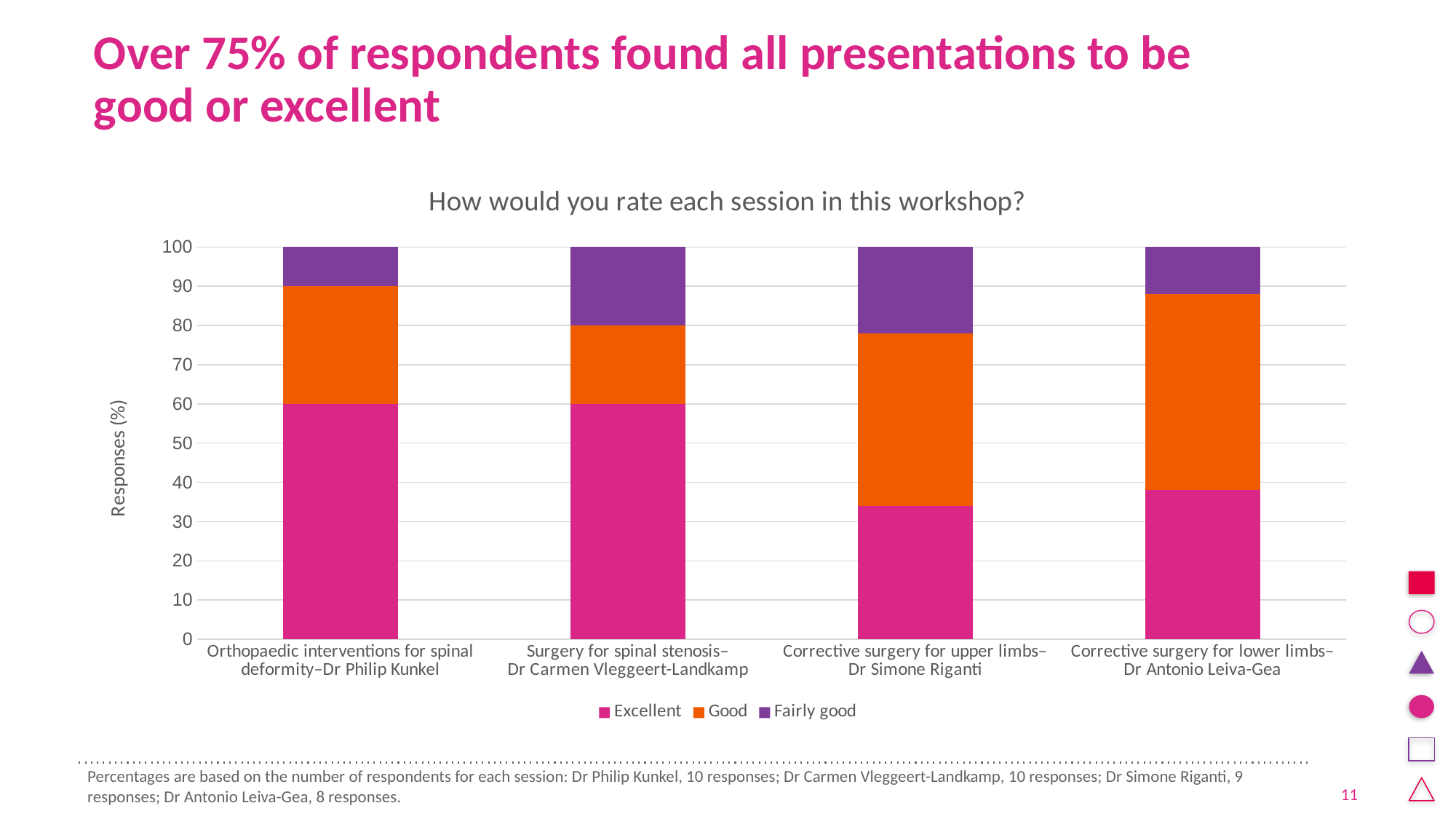
What kind of chart is shown on the slide? Stacked bar chart What is the Excellent value for 'Surgery for spinal stenosis–Dr Carmen Vleggeert-Landkamp'? 60 What is the title of the chart? How would you rate each session in this workshop? How many sessions (categories) are shown on the x axis of the chart? 4 What is the total of the stacked bar for 'Surgery for spinal stenosis–Dr Carmen Vleggeert-Landkamp'? 100 Which session has the smallest Good segment? Surgery for spinal stenosis–Dr Carmen Vleggeert-Landkamp Which has the larger Excellent value: Dr Philip Kunkel's session or Dr Simone Riganti's session? Dr Philip Kunkel's session What is the Excellent value for 'Orthopaedic interventions for spinal deformity–Dr Philip Kunkel'? 60 Is the Excellent value for 'Corrective surgery for upper limbs–Dr Simone Riganti' greater or less than 40? less How many series does the chart's legend list? 3 Which session has the largest Good segment? Corrective surgery for lower limbs–Dr Antonio Leiva-Gea Is the Excellent value for 'Corrective surgery for lower limbs–Dr Antonio Leiva-Gea' greater or less than 30? greater